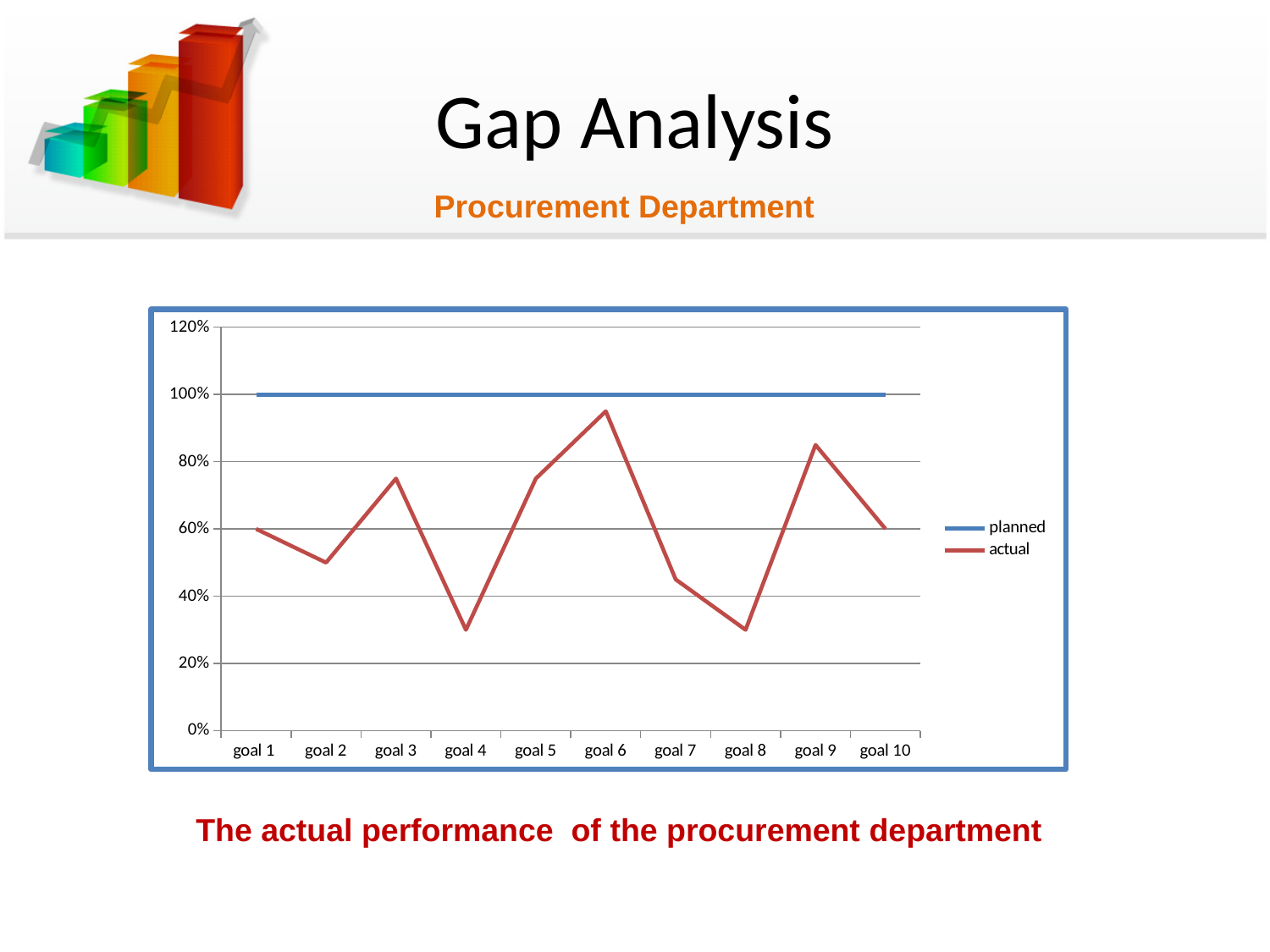
Which is larger, the actual value for goal 6 or the actual value for goal 9? goal 6 Is the actual value for goal 6 greater or less than 80%? greater What is the planned value for goal 5? 100% Is the actual value for goal 2 greater or less than 60%? less Is the actual value for goal 4 greater or less than 40%? less What kind of chart is shown on the slide? line chart How many series does the legend list? 2 Which goal has the highest actual value? goal 6 Does the actual line rise or fall from goal 4 to goal 6? rise How many goals are shown along the x axis? 10 What colour is the planned line? blue What are the two entries in the legend? planned, actual